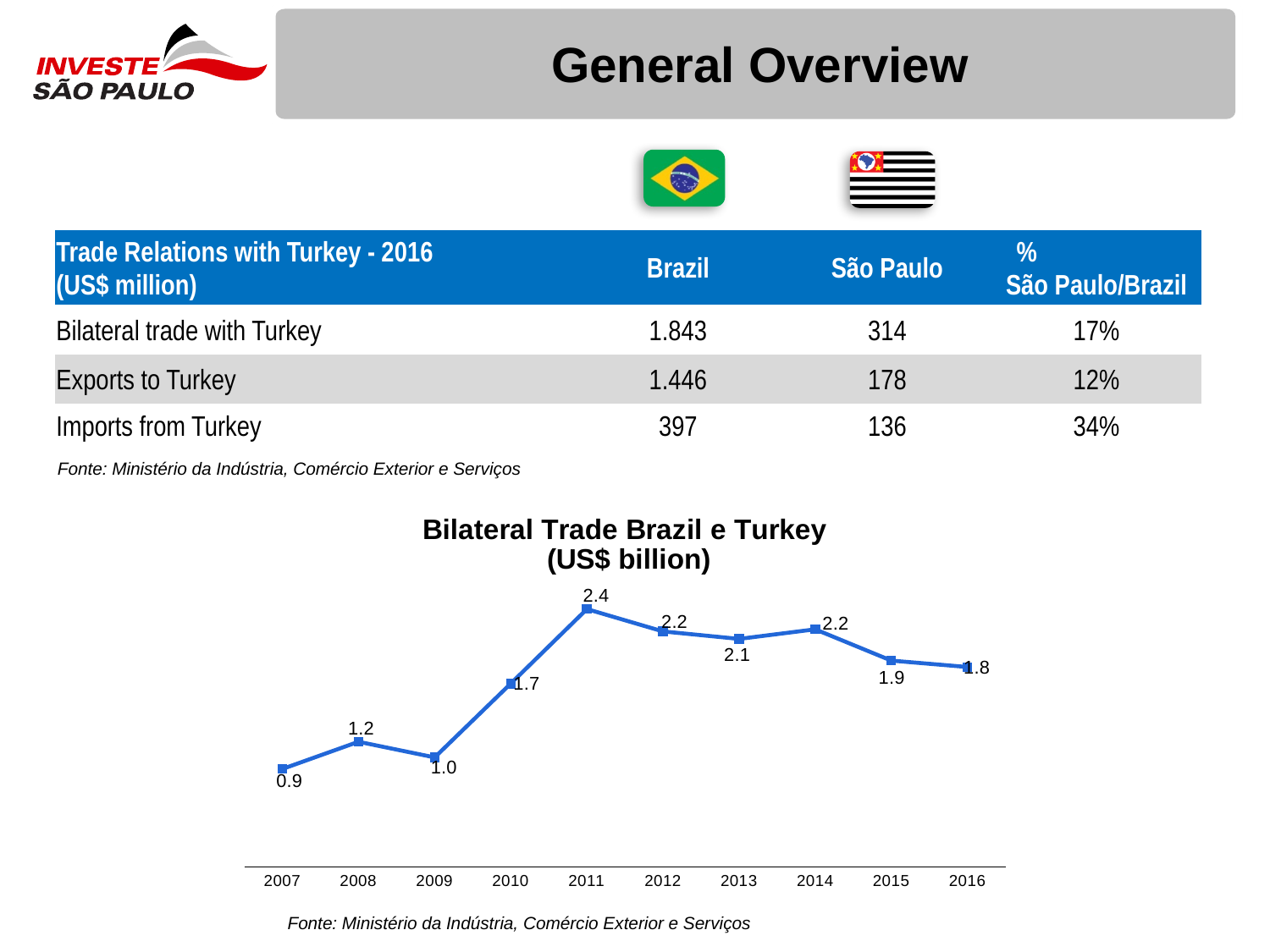
What is the value for 2016 in the Bilateral Trade Brazil e Turkey chart? 1.8 What is the difference between the 2011 and 2007 values in the Bilateral Trade Brazil e Turkey chart? 1.5 What is the value for 2010 in the Bilateral Trade Brazil e Turkey chart? 1.7 What is the value for 2011 in the Bilateral Trade Brazil e Turkey chart? 2.4 Which year has the highest value in the Bilateral Trade Brazil e Turkey chart? 2011 What kind of chart is the Bilateral Trade Brazil e Turkey chart? Line chart What is the value for 2007 in the Bilateral Trade Brazil e Turkey chart? 0.9 In the Bilateral Trade Brazil e Turkey chart, do the values rise or fall from 2011 to 2016? Fall How many years are plotted in the Bilateral Trade Brazil e Turkey chart? 10 What is the difference between the 2015 and 2016 values in the Bilateral Trade Brazil e Turkey chart? 0.1 Which year has the lowest value in the Bilateral Trade Brazil e Turkey chart? 2007 In the Bilateral Trade Brazil e Turkey chart, which is larger, the value for 2008 or the value for 2009? 2008